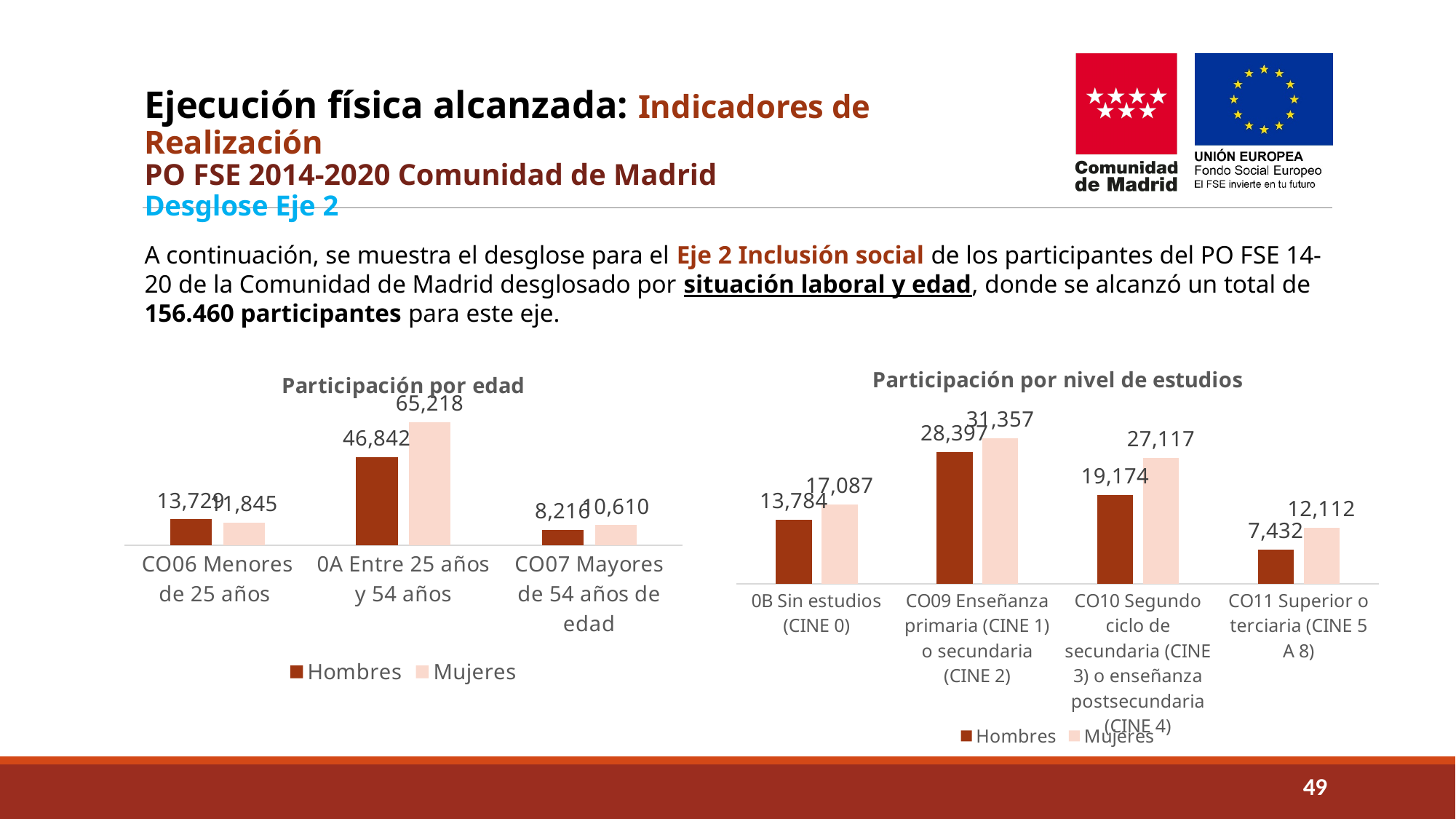
In the 'Participación por nivel de estudios' chart, what is the value for Hombres in 'CO11 Superior o terciaria (CINE 5 A 8)'? 7,432 In the 'Participación por edad' chart, what is the value for Hombres in the category '0A Entre 25 años y 54 años'? 46,842 In the 'Participación por nivel de estudios' chart, which is larger for '0B Sin estudios (CINE 0)': Hombres or Mujeres? Mujeres In the 'Participación por nivel de estudios' chart, which category has the lowest value for Mujeres? CO11 Superior o terciaria (CINE 5 A 8) How many series does the legend of the 'Participación por edad' chart list? 2 In the 'Participación por nivel de estudios' chart, which category has the highest value for Hombres? CO09 Enseñanza primaria (CINE 1) o secundaria (CINE 2) In the 'Participación por edad' chart, what is the difference between Mujeres and Hombres for '0A Entre 25 años y 54 años'? 18,376 In the 'Participación por nivel de estudios' chart, what is the difference between Mujeres and Hombres for 'CO09 Enseñanza primaria (CINE 1) o secundaria (CINE 2)'? 2,960 How many categories are shown in the 'Participación por edad' chart? 3 In the 'Participación por edad' chart, what is the value for Mujeres in the category '0A Entre 25 años y 54 años'? 65,218 In the 'Participación por edad' chart, which category has the highest value for Mujeres? 0A Entre 25 años y 54 años In the 'Participación por nivel de estudios' chart, what is the value for Mujeres in 'CO10 Segundo ciclo de secundaria (CINE 3) o enseñanza postsecundaria (CINE 4)'? 27,117